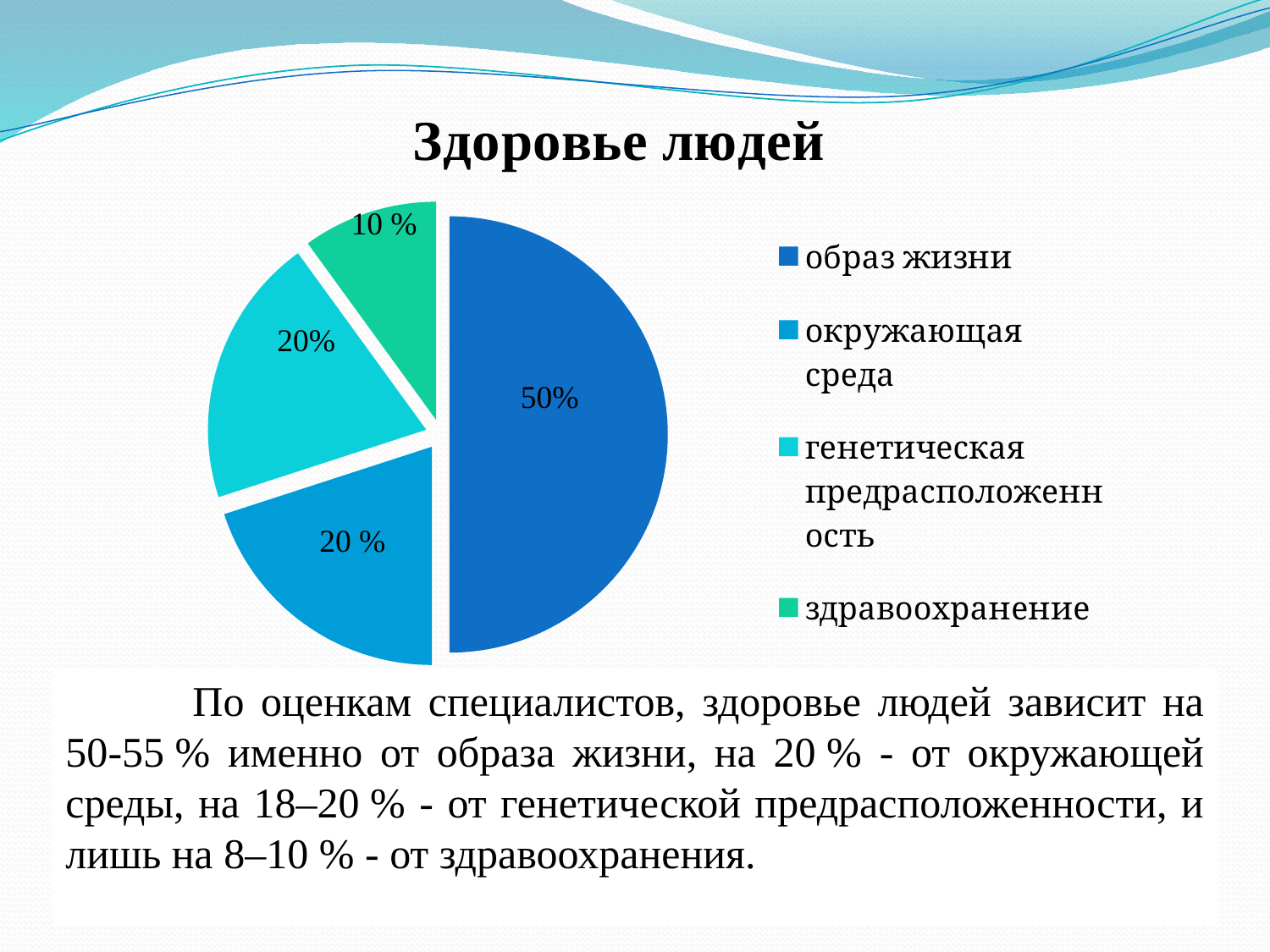
What type of chart is shown on the slide? pie chart Which category has the smallest slice of the pie? здравоохранение Which category has the largest slice of the pie? образ жизни What share of the pie is labelled for образ жизни? 50% What share of the pie is labelled for здравоохранение? 10 % How many slices does the pie chart have? 4 How many entries does the legend list? 4 What is the difference in percentage points between the образ жизни slice and the здравоохранение slice? 40 What is the title of the chart? Здоровье людей Which slice is larger: образ жизни or окружающая среда? образ жизни What share of the pie is labelled for генетическая предрасположенность? 20% What share of the pie is labelled for окружающая среда? 20 %